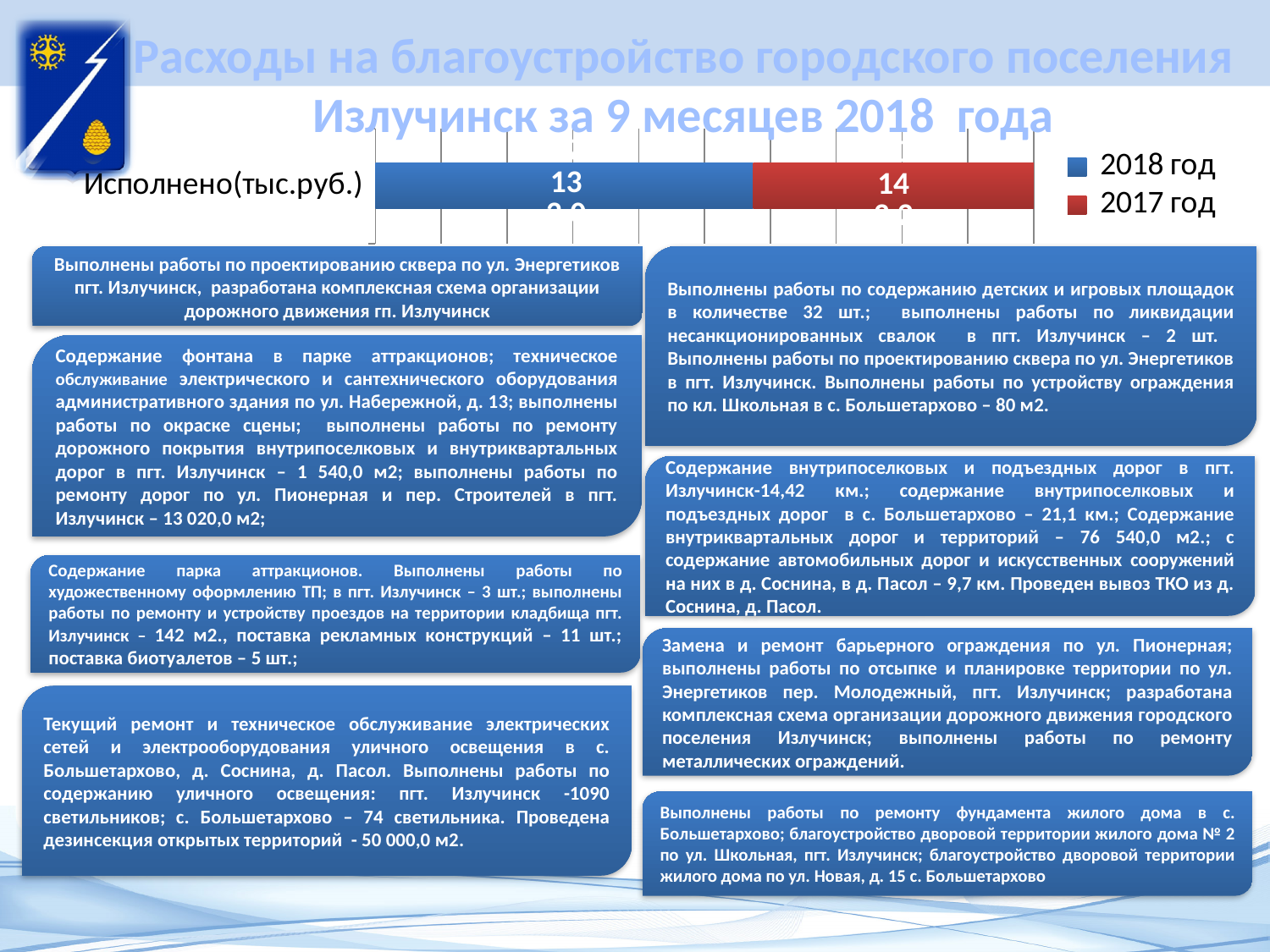
How many categories are plotted on the chart? 1 What kind of chart is shown on the slide? bar chart How many series does the chart legend list? 2 What is the label of the single category plotted on the chart? Исполнено(тыс.руб.) Which two series are listed in the chart legend? 2018 год and 2017 год Which colour represents the series 2017 год in the chart? red